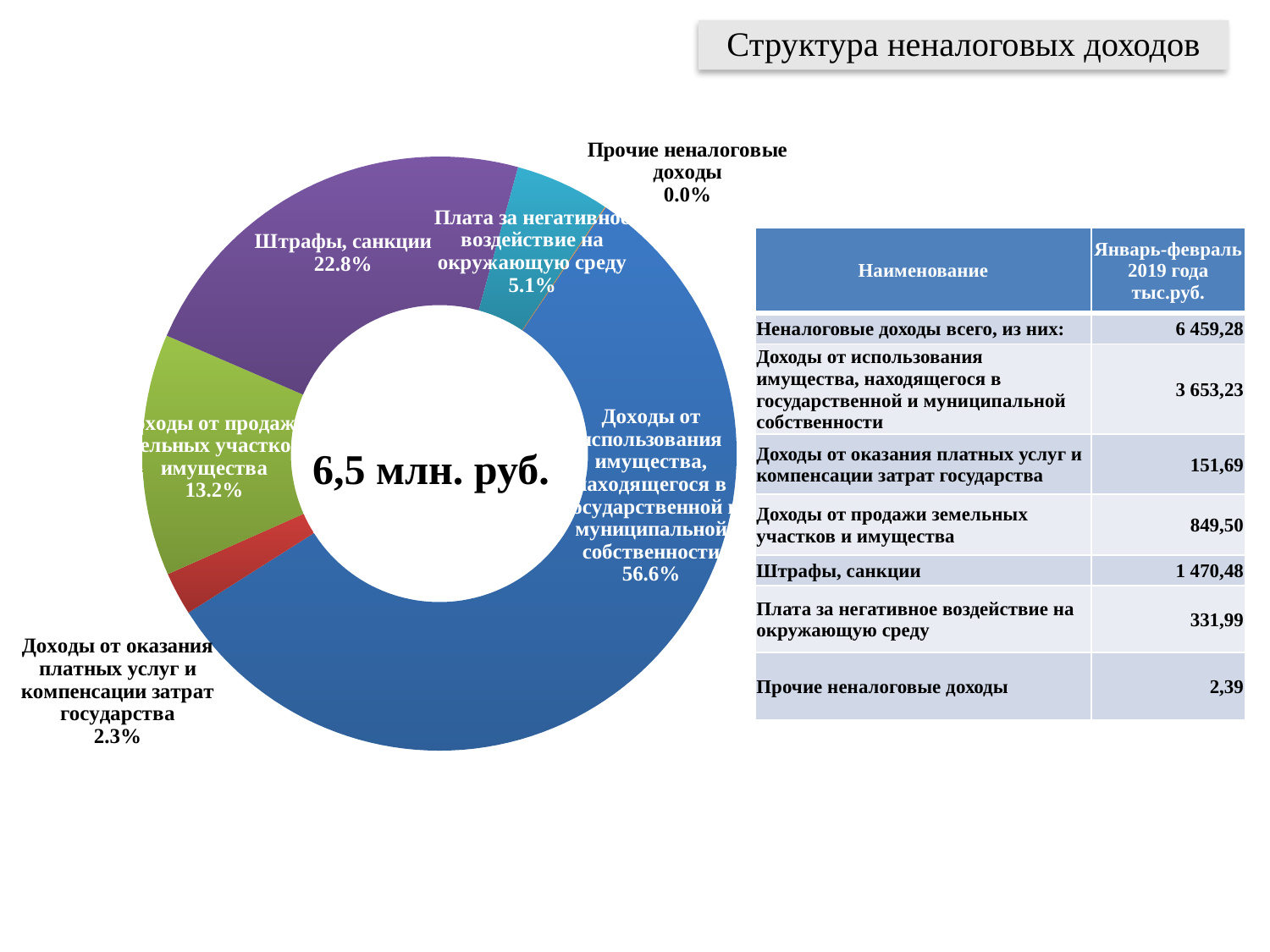
Which category has the largest slice of the pie? Доходы от использования имущества, находящегося в государственной и муниципальной собственности What total amount is printed in the centre of the doughnut chart? 6,5 млн. руб. What share of the pie does "Штрафы, санкции" hold? 22.8% Which category has the smallest slice of the pie? Прочие неналоговые доходы What share of the pie does "Плата за негативное воздействие на окружающую среду" hold? 5.1% What is the difference in percentage points between the "Штрафы, санкции" slice and the "Плата за негативное воздействие на окружающую среду" slice? 17.7 Which slice is larger: "Штрафы, санкции" or "Доходы от оказания платных услуг и компенсации затрат государства"? Штрафы, санкции What share of the pie does "Доходы от оказания платных услуг и компенсации затрат государства" hold? 2.3% How many categories are shown in the pie chart? 6 What kind of chart is shown on the slide? Pie (doughnut) chart What share of the pie does "Прочие неналоговые доходы" hold? 0.0% What is the title of the slide? Структура неналоговых доходов